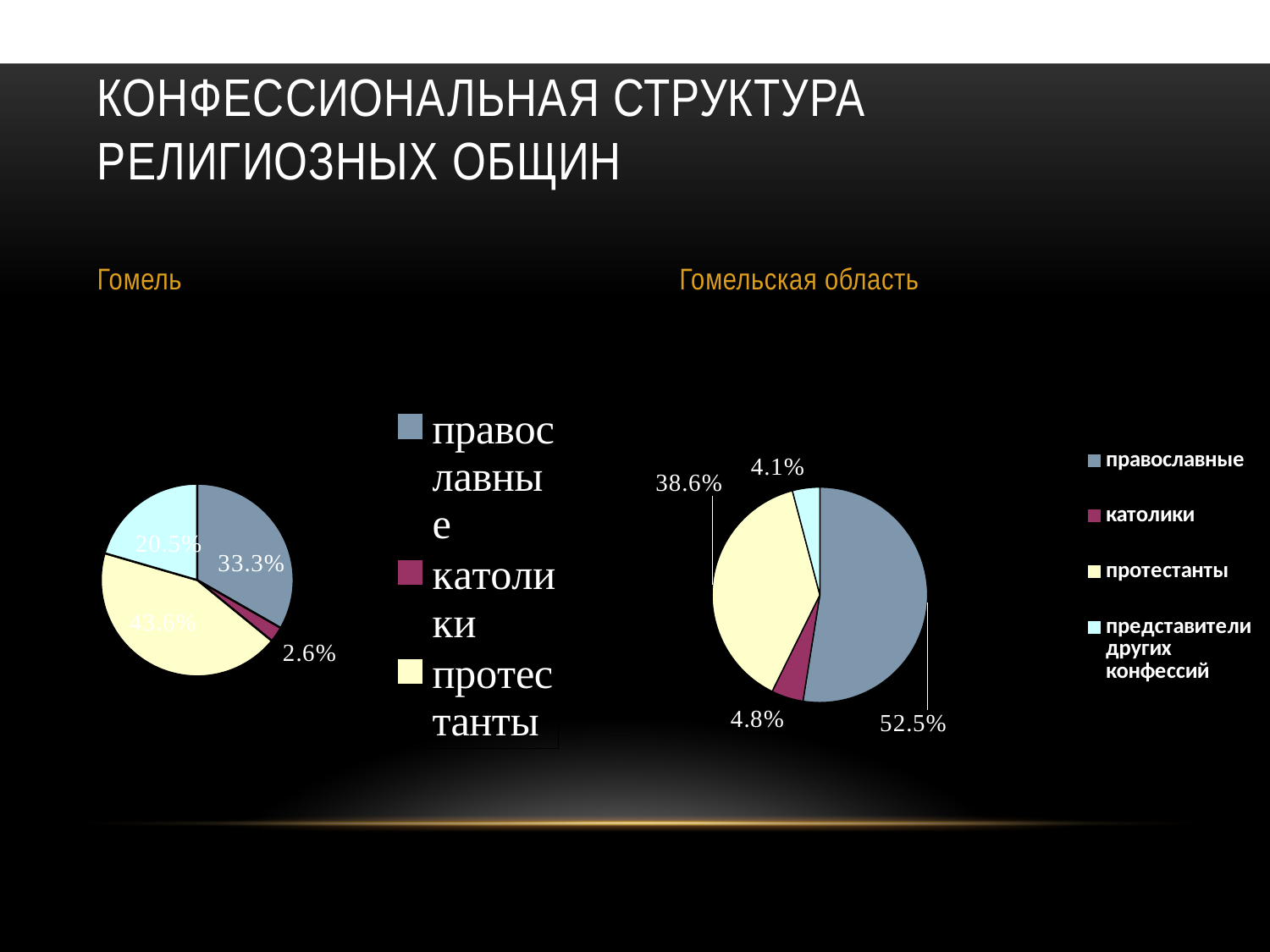
How many entries does the legend of the Гомельская область chart list? 4 In the Гомельская область chart, what share is shown for представители других конфессий? 4.1% In the Гомель chart, what share is shown for католики? 2.6% Is the православные share larger in the Гомель chart or in the Гомельская область chart? Гомельская область In the Гомельская область chart, which group has the largest slice? православные In the Гомель chart, what share is shown for православные? 33.3% In the Гомельская область chart, what share is shown for католики? 4.8% What type of chart is the Гомель chart? pie chart In the Гомельская область chart, what share is shown for православные? 52.5% In the Гомельская область chart, what share is shown for протестанты? 38.6% In the Гомельская область chart, what is the difference between the православные and протестанты shares? 13.9% In the Гомельская область chart, which group has the smallest slice? представители других конфессий